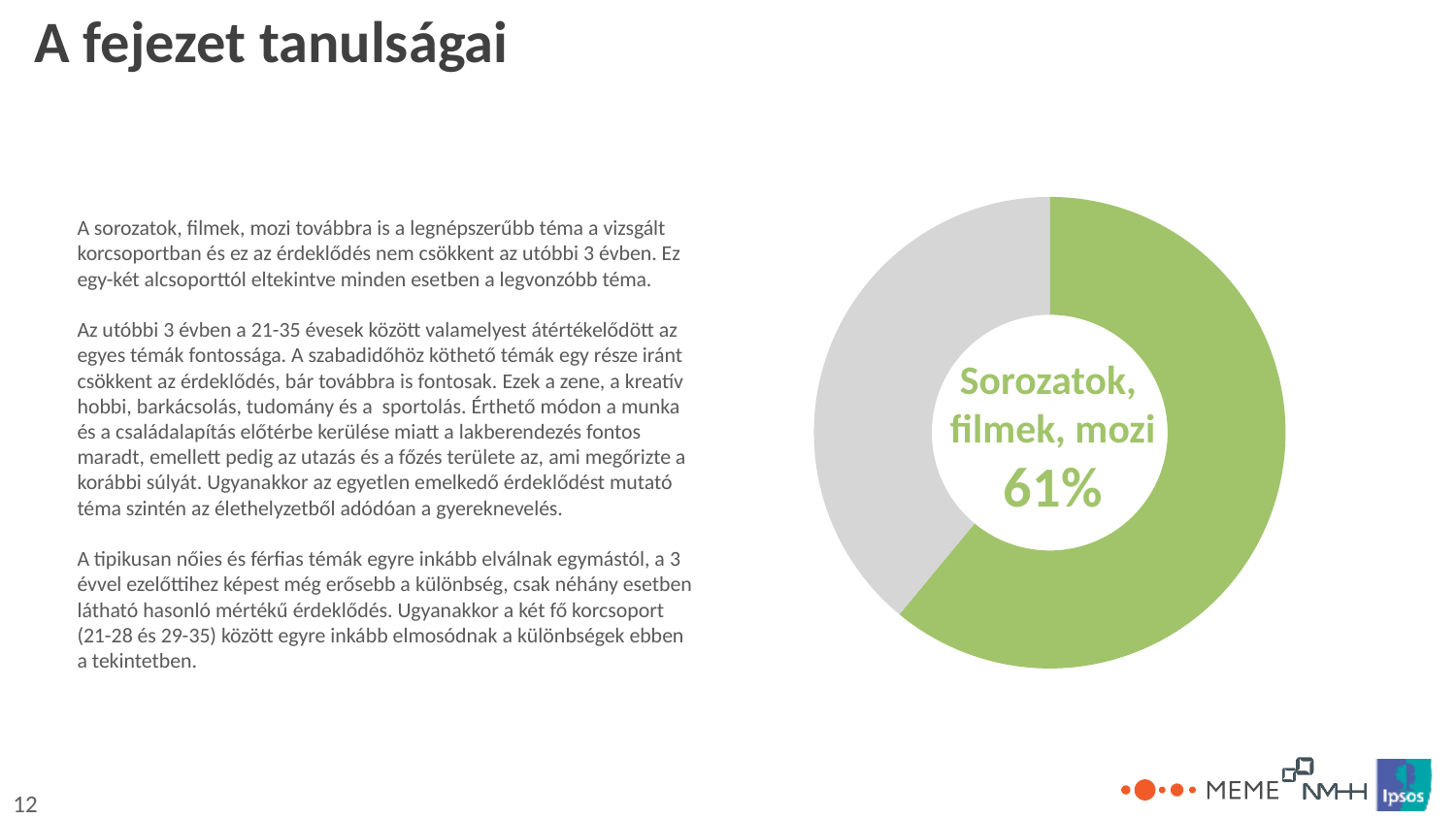
What label is printed in the centre of the pie chart? Sorozatok, filmek, mozi What colour is the slice representing "Sorozatok, filmek, mozi"? green What share of the pie does the green slice represent? 61% What kind of chart is shown on the right side of the slide? pie chart (donut) What percentage is shown for "Sorozatok, filmek, mozi" in the chart? 61% Is the value for "Sorozatok, filmek, mozi" greater or less than 75%? less How many slices does the pie chart have? 2 Is the value for "Sorozatok, filmek, mozi" greater or less than 50%? greater Is the grey portion of the pie chart greater or less than 50%? less Which slice of the pie chart is larger, the green one or the grey one? the green one